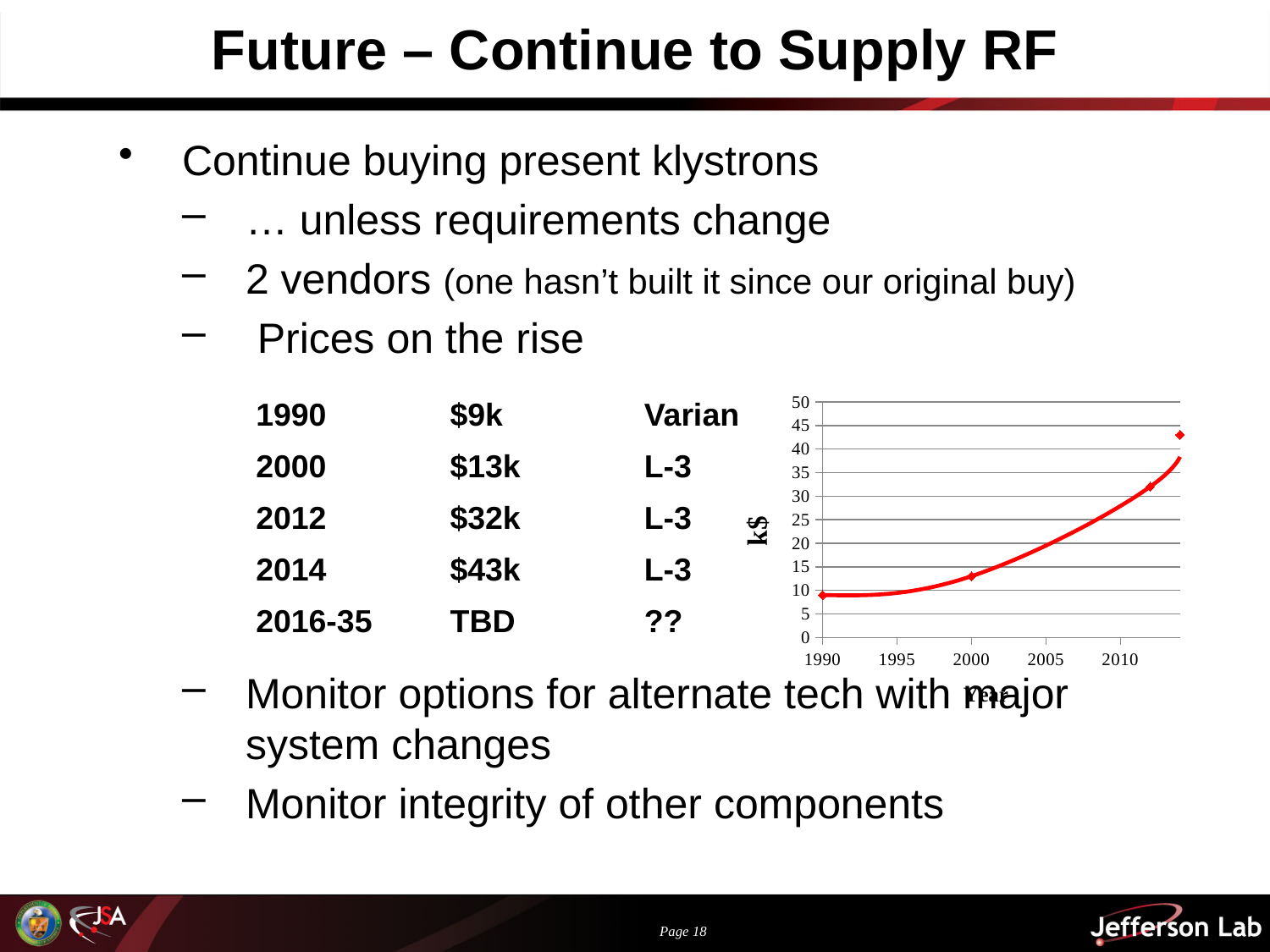
Is the plotted value for 2000 greater or less than 15? less How many data points are plotted on the chart? 4 Which year has the highest plotted value on the chart? 2014 Is the plotted value for 1990 greater or less than 10? less Which year has the lowest plotted value on the chart? 1990 Is the plotted value for 2012 greater or less than 30? greater Do the plotted values rise or fall as the year increases along the x axis? rise What is the label on the chart's vertical axis? k$ What kind of chart is shown on the slide? line chart What is the highest tick value shown on the chart's vertical axis? 50 Which is larger on the chart, the value for 2000 or the value for 2012? 2012